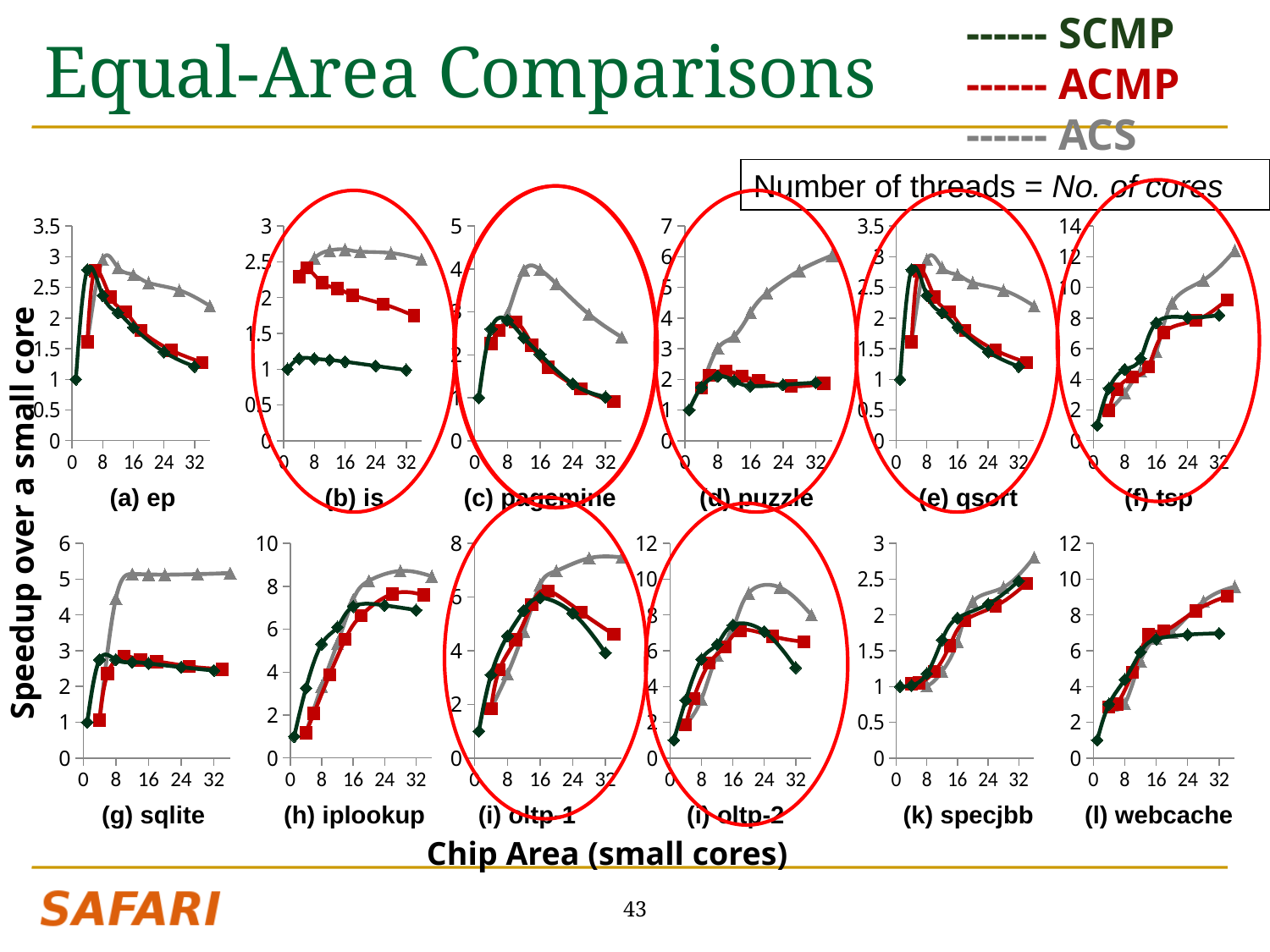
How many chart panels are shown on the slide? 12 In the (a) ep chart, is the SCMP value at chip area 32 greater or less than 2? less In the (i) oltp-1 chart, at chip area 32, which series is higher, SCMP or ACS? ACS In the (k) specjbb chart, do the speedup values rise or fall as chip area increases? rise What is the label of the shared x axis for the charts? Chip Area (small cores) What kind of chart is used in each of the panels on this slide? line chart In the (f) tsp chart, is the ACS value at chip area 32 greater or less than 10? greater In the (b) is chart, at chip area 32, which series is higher, SCMP or ACS? ACS How many series does the legend at the top right list? 3 In the (d) puzzle chart, which series reaches the highest speedup? ACS In the (b) is chart, is the ACS value at chip area 16 greater or less than 2? greater